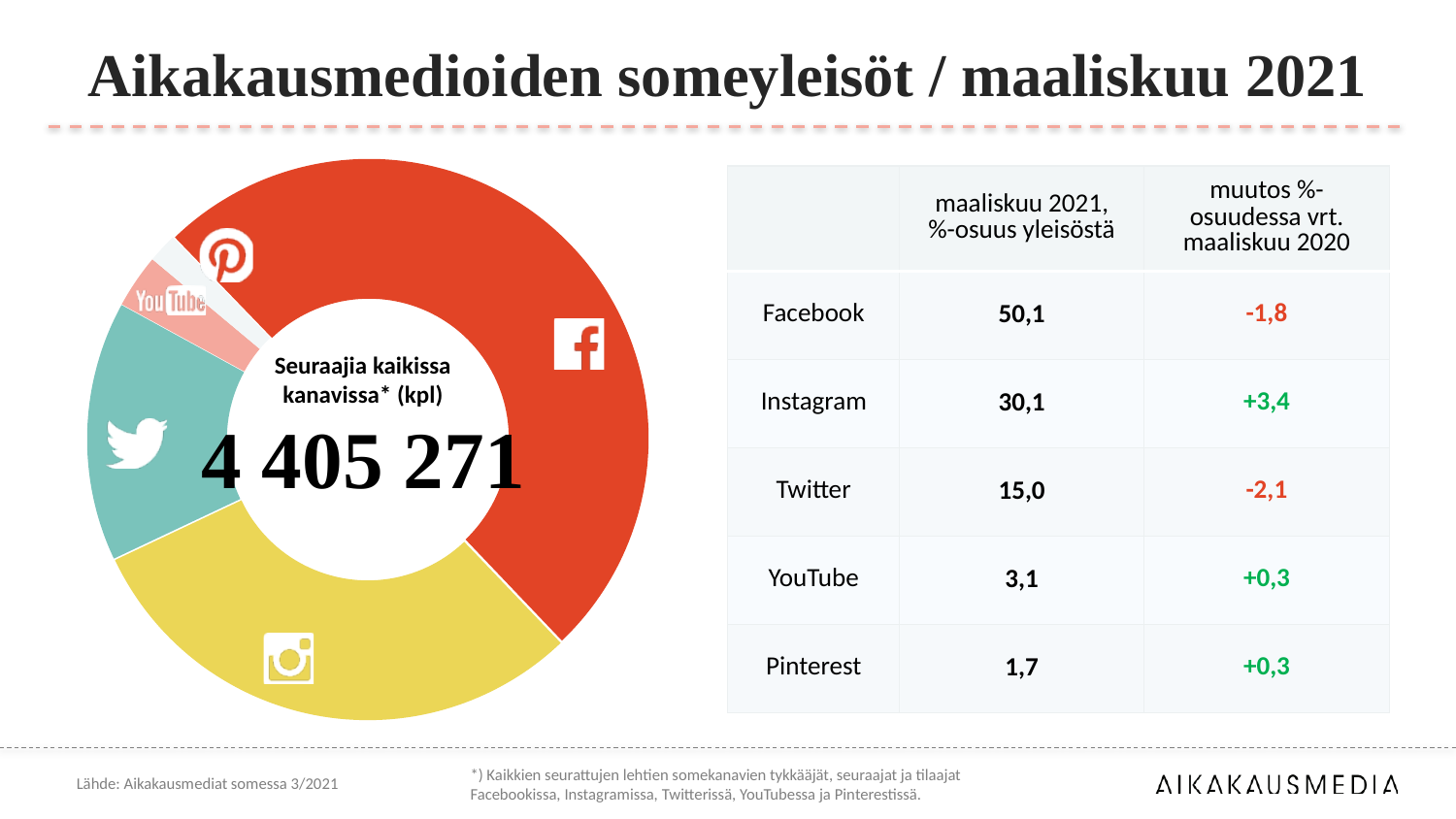
What kind of chart is shown on the left of the slide? pie chart (donut) Which has a larger share of the audience, Instagram or Twitter? Instagram How many slices does the donut chart have? 5 What is the title of the slide? Aikakausmedioiden someyleisöt / maaliskuu 2021 What is Instagram's share of the audience in March 2021? 30,1 Which channel has the smallest share of the audience in March 2021? Pinterest What is Facebook's share of the audience in March 2021? 50,1 What is the change in Instagram's percentage share compared with March 2020? +3,4 What is the difference in percentage share between Facebook and Instagram? 20,0 What total number of followers (Seuraajia kaikissa kanavissa) is shown in the centre of the donut chart? 4 405 271 Which channel has the largest share of the audience in March 2021? Facebook What is the change in Facebook's percentage share compared with March 2020? -1,8